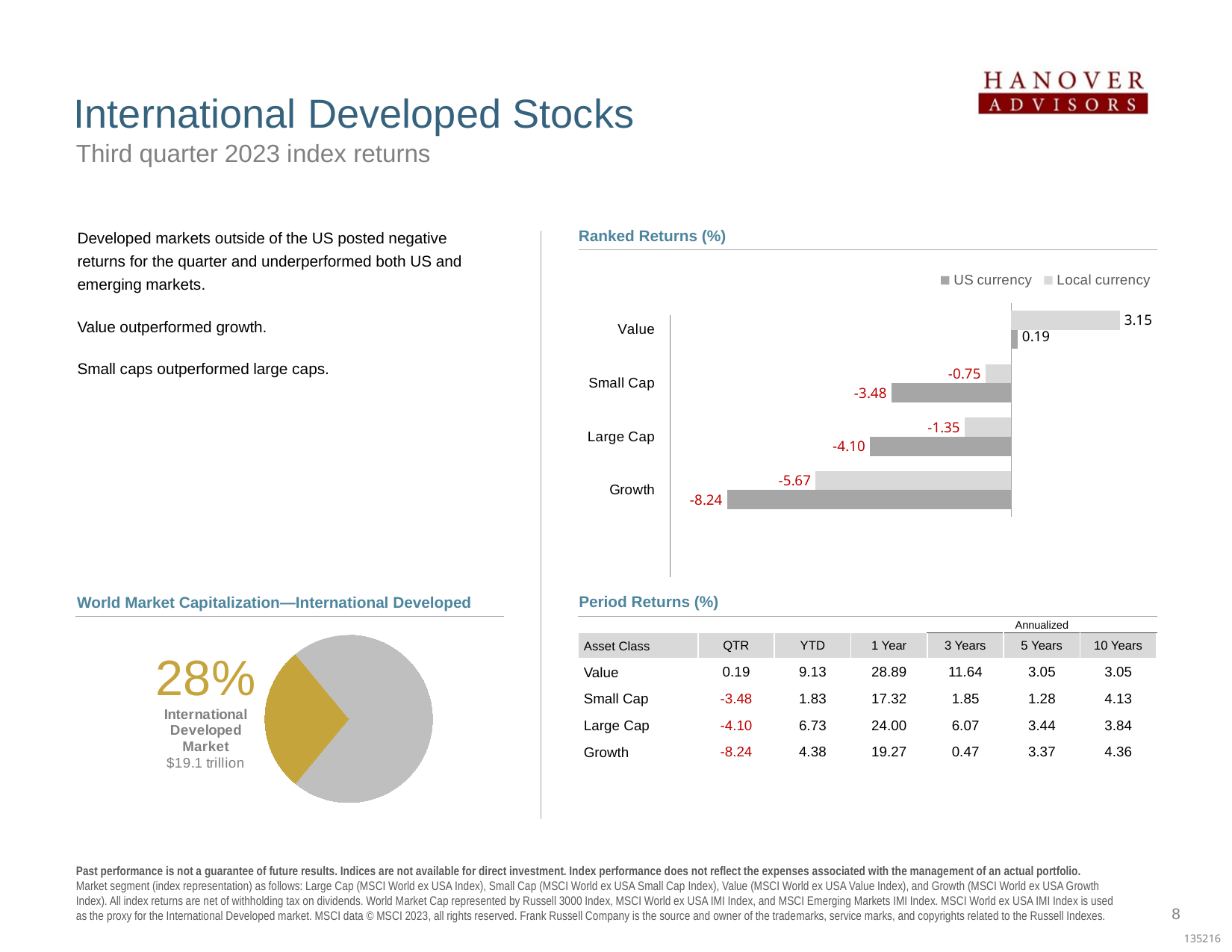
In the Ranked Returns (%) chart, which category has the lowest US currency return? Growth In the Ranked Returns (%) chart, what is the US currency return for Large Cap? -4.10 In the Ranked Returns (%) chart, which is larger: the US currency return for Small Cap or the US currency return for Large Cap? Small Cap In the World Market Capitalization—International Developed pie chart, what dollar value is given for the International Developed Market? $19.1 trillion In the World Market Capitalization—International Developed pie chart, what share does the International Developed Market represent? 28% How many categories are shown in the Ranked Returns (%) chart? 4 In the Ranked Returns (%) chart, what is the difference between the Local currency and US currency returns for Value? 2.96 What kind of chart is the Ranked Returns (%) chart? Bar chart In the Ranked Returns (%) chart, what is the US currency return for Value? 0.19 How many series does the legend of the Ranked Returns (%) chart list? 2 In the Ranked Returns (%) chart, which category has the highest Local currency return? Value In the Ranked Returns (%) chart, what is the Local currency return for Growth? -5.67